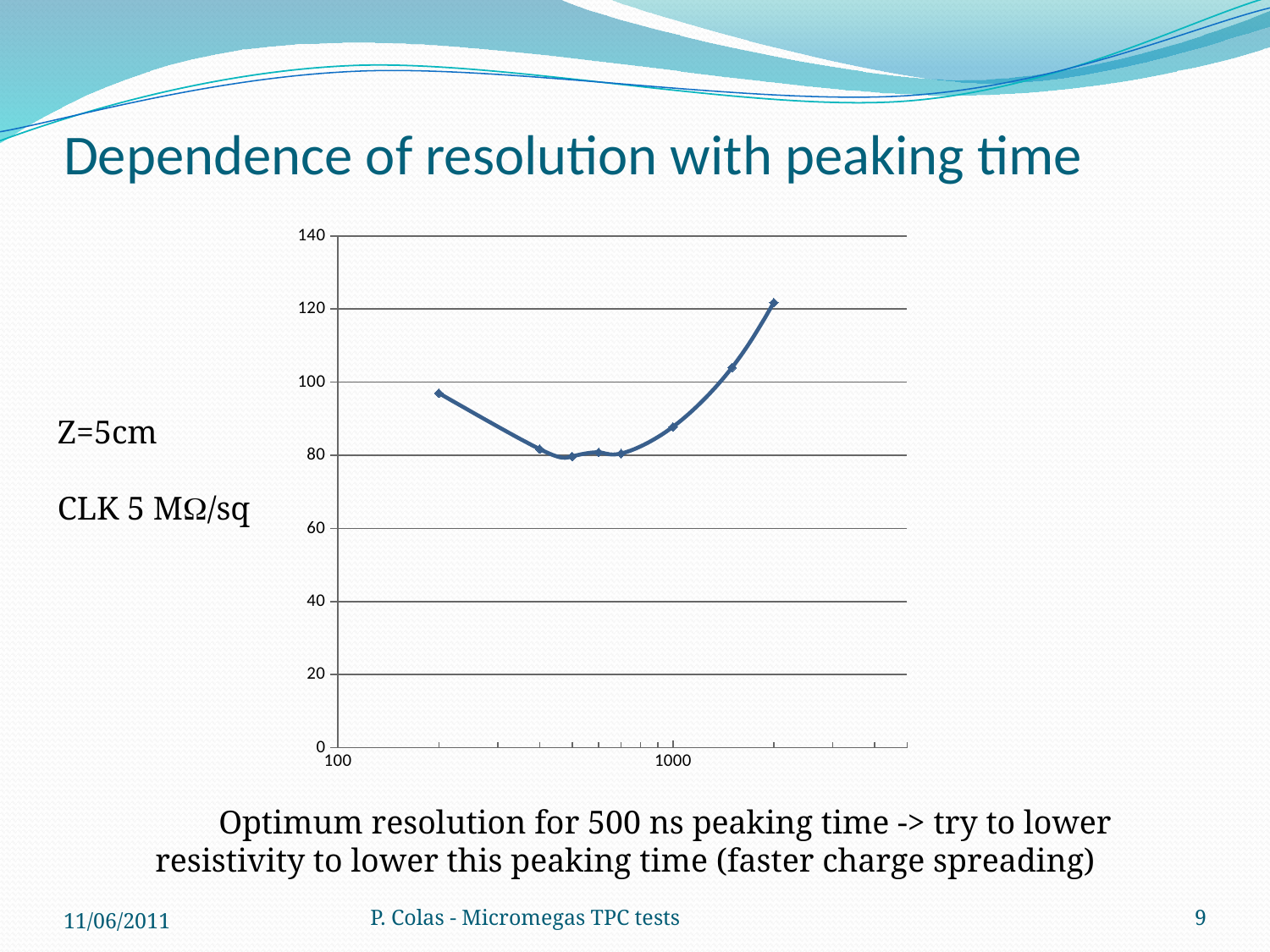
What is the title of the slide containing the chart? Dependence of resolution with peaking time What kind of chart is shown on the slide? line chart Is the value of the leftmost data point greater or less than 80? greater Is the value of the data point at x = 1000 greater or less than 100? less Is the value of the rightmost data point greater or less than 100? greater Which data point has the highest value, the leftmost or the rightmost? the rightmost Does the curve rise or fall between the leftmost point and the lowest point? fall Does the curve rise or fall from x = 1000 to the rightmost point? rise How many data points are plotted on the chart? 8 What is the highest value shown on the y axis? 140